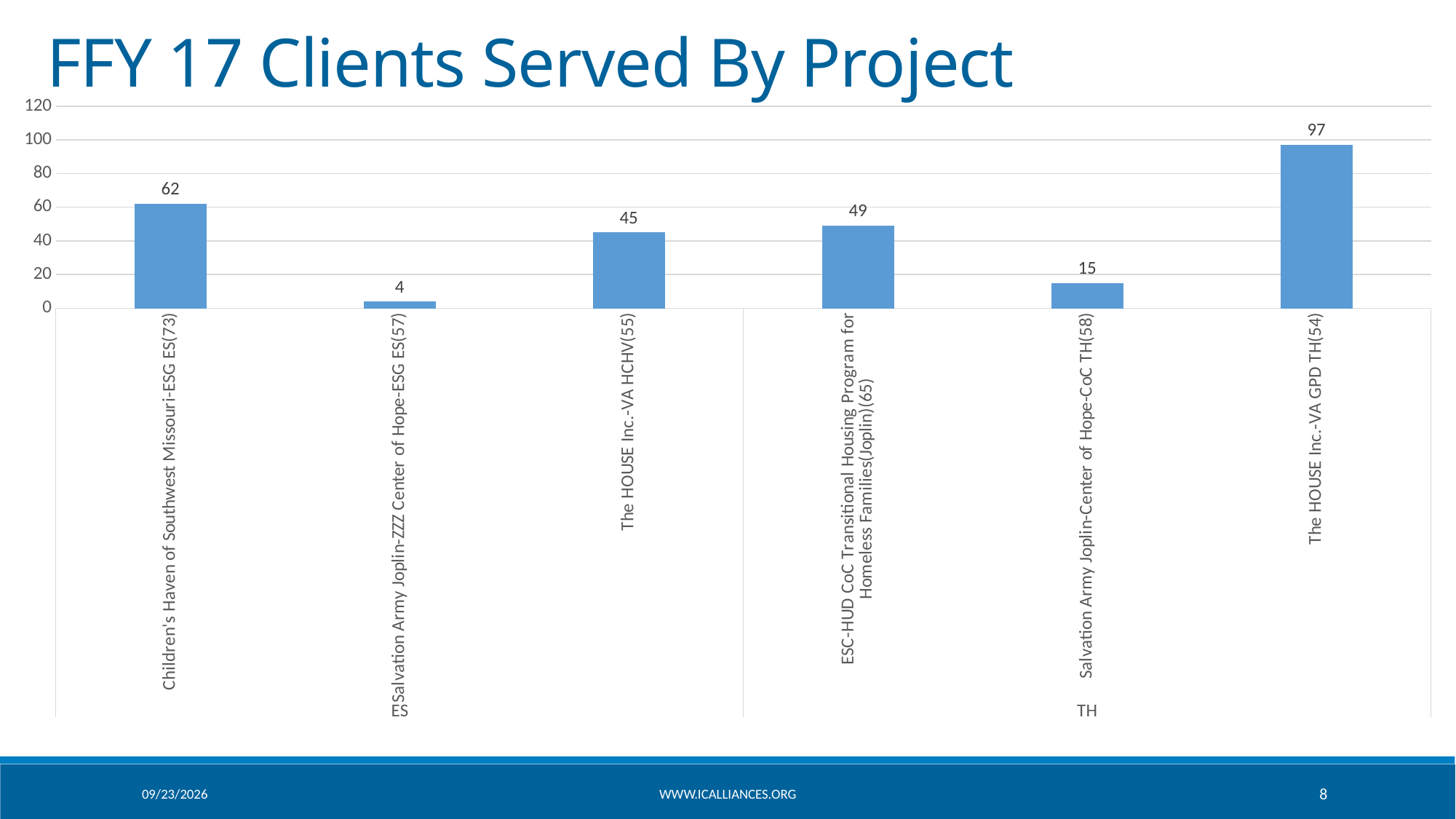
What is the title of the chart? FFY 17 Clients Served By Project Which project served the fewest clients? Salvation Army Joplin-ZZZ Center of Hope-ESG ES(57) What kind of chart is shown on the slide? Bar chart How many projects are shown in the chart? 6 What is the value for The HOUSE Inc.-VA GPD TH(54)? 97 What is the difference between the values for The HOUSE Inc.-VA GPD TH(54) and Children's Haven of Southwest Missouri-ESG ES(73)? 35 What is the value for Salvation Army Joplin-Center of Hope-CoC TH(58)? 15 Which is larger: the value for The HOUSE Inc.-VA HCHV(55) or the value for ESC-HUD CoC Transitional Housing Program for Homeless Families(Joplin)(65)? ESC-HUD CoC Transitional Housing Program for Homeless Families(Joplin)(65) Which project served the most clients? The HOUSE Inc.-VA GPD TH(54) What is the value for ESC-HUD CoC Transitional Housing Program for Homeless Families(Joplin)(65)? 49 Is the value for The HOUSE Inc.-VA GPD TH(54) greater or less than 80? greater How many clients were served by Children's Haven of Southwest Missouri-ESG ES(73)? 62